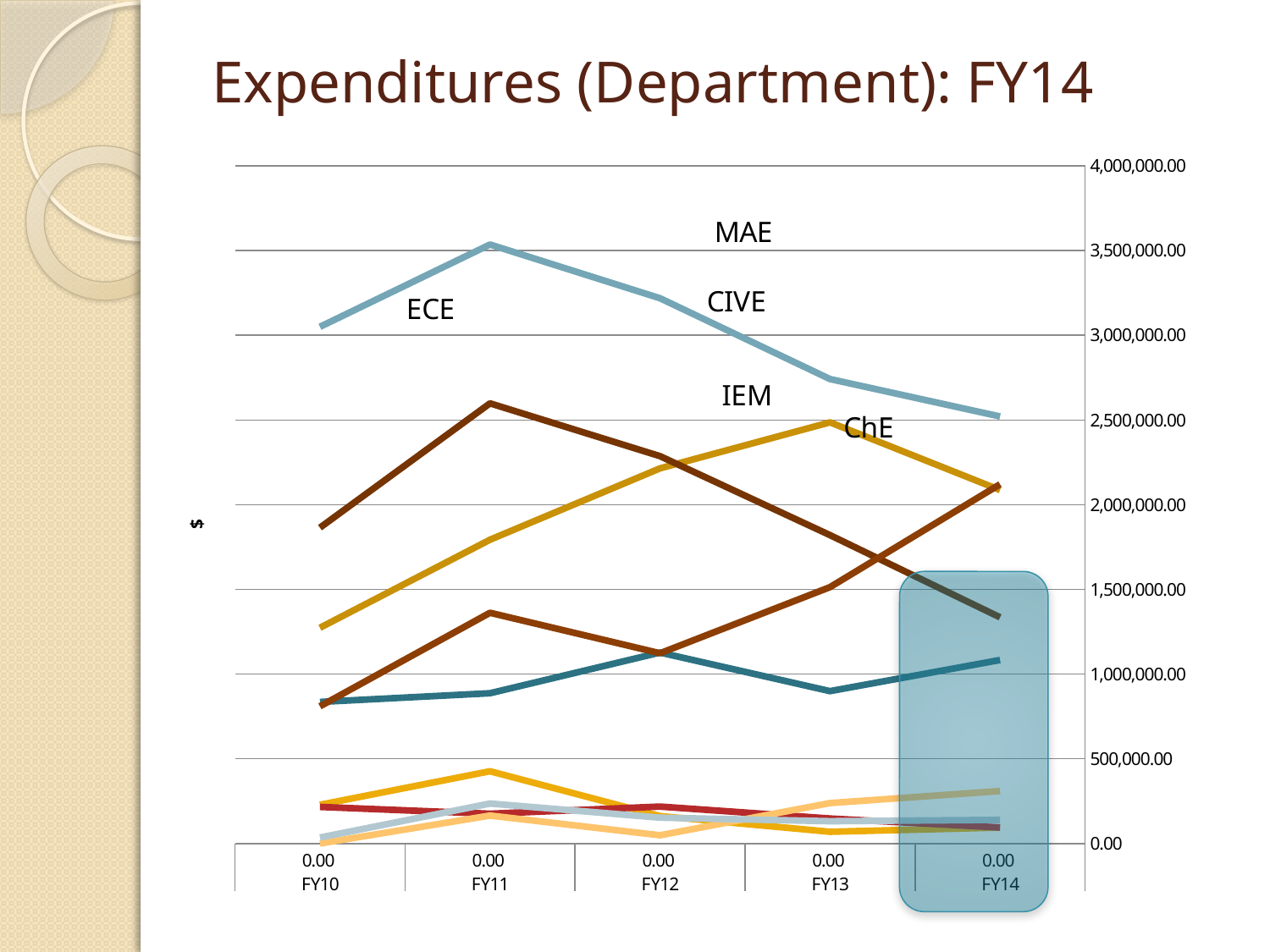
Is the value of the topmost line at FY14 greater or less than 2,000,000.00? greater In which fiscal year does the topmost line reach its highest point? FY11 Does the topmost line rise or fall from FY11 to FY14? fall What is the title of the chart? Expenditures (Department): FY14 Is the value of the topmost line at FY10 greater or less than 3,500,000.00? less Is the value of the gold line that peaks at FY13 greater or less than 2,000,000.00 at FY14? greater What type of chart is shown on the slide? line chart What is the highest value shown on the y axis? 4,000,000.00 How many fiscal years are shown along the x axis? 5 Which fiscal year is highlighted with a shaded box on the chart? FY14